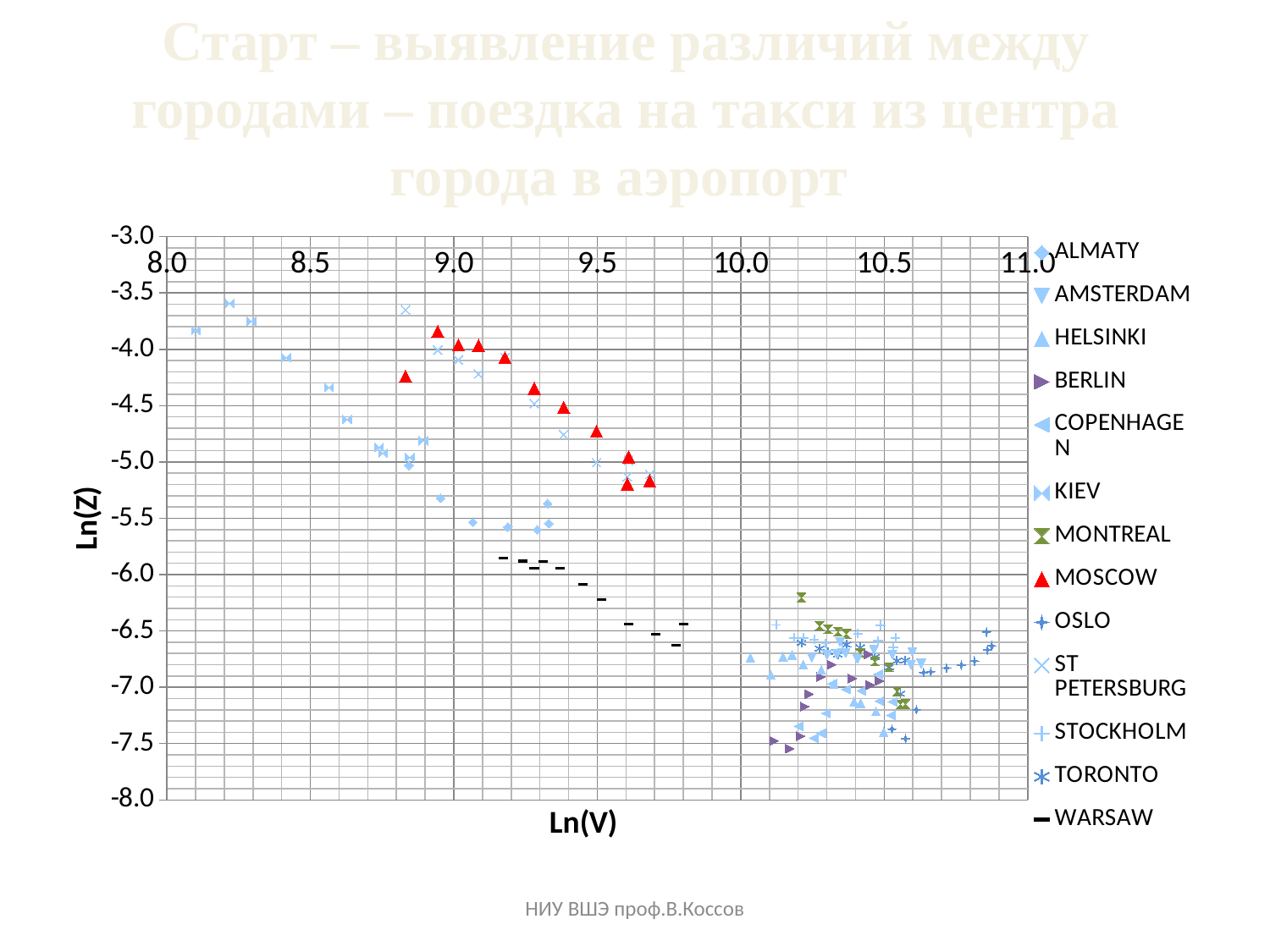
Are the Ln(V) values of the KIEV points greater or less than 9.0? less Which series has higher Ln(V) values, KIEV or HELSINKI? HELSINKI Are the Ln(V) values of the BERLIN points greater or less than 10.0? greater Are the Ln(Z) values of the WARSAW points greater or less than -5.5? less What kind of chart is shown on the slide? scatter chart Do the MOSCOW points rise or fall in Ln(Z) as Ln(V) increases? fall Which series has higher Ln(Z) values, MOSCOW or WARSAW? MOSCOW Which series is plotted with red triangle markers? MOSCOW What is the title of the horizontal axis? Ln(V) What is the title of the vertical axis? Ln(Z) How many series does the legend list? 13